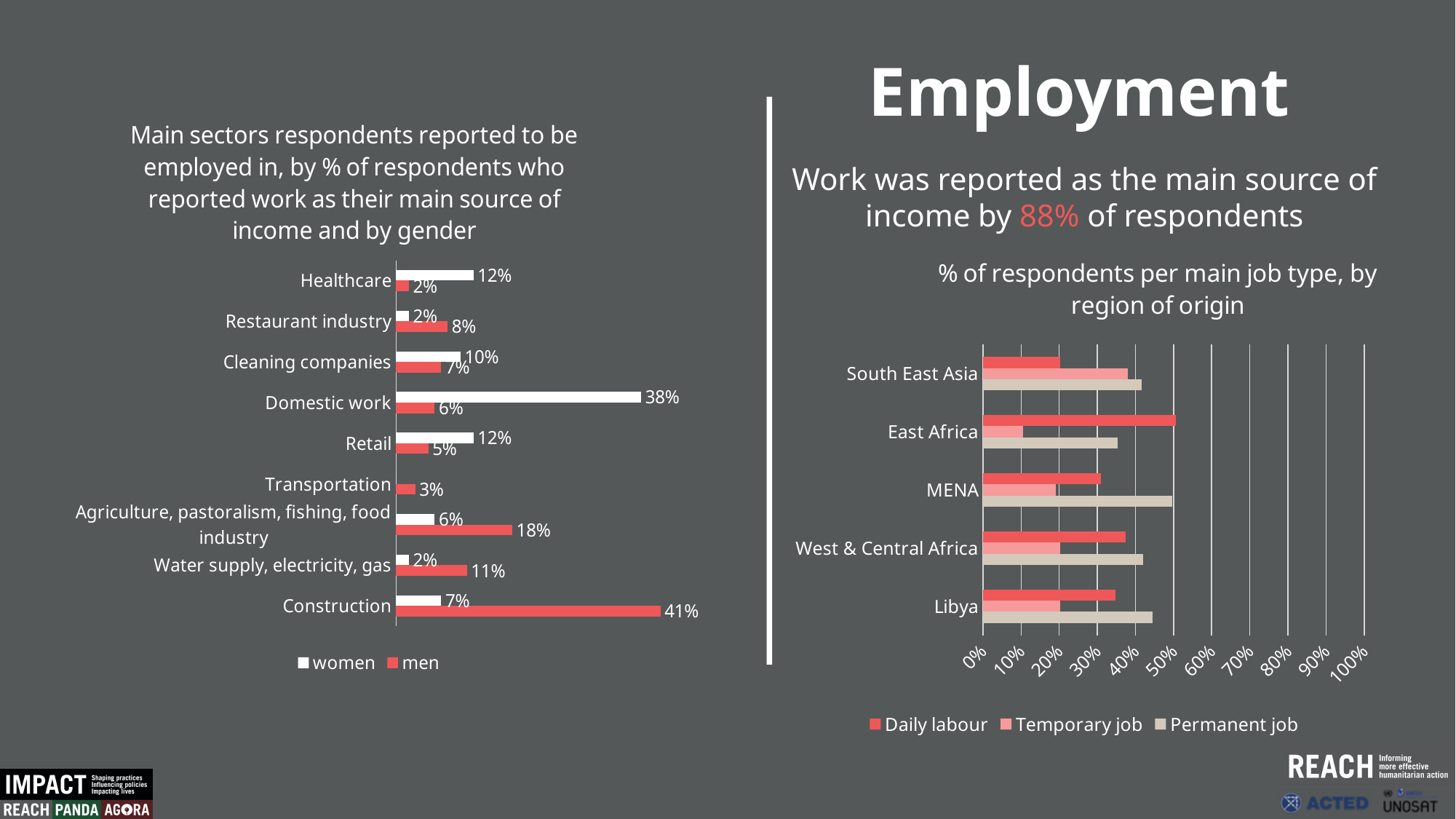
On the left chart about main sectors by gender, how many series does the legend list? 2 On the right chart about main job type by region of origin, how many regions are shown? 5 What kind of chart is the right chart about main job type by region of origin? bar chart On the left chart about main sectors by gender, which sector has the highest value for men? Construction On the right chart about main job type by region of origin, which region has the highest value for daily labour? East Africa On the left chart about main sectors by gender, what is the difference between the men and women values for agriculture, pastoralism, fishing, food industry? 12% On the left chart about main sectors by gender, what percentage of women reported domestic work? 38% On the right chart about main job type by region of origin, is the daily labour value for Libya greater or less than 30%? greater On the left chart about main sectors by gender, what is the men value for transportation? 3% On the left chart about main sectors by gender, which sector has the highest value for women? Domestic work On the left chart about main sectors by gender, which is larger for healthcare: the women value or the men value? women On the left chart about main sectors by gender, what percentage of men reported construction? 41%